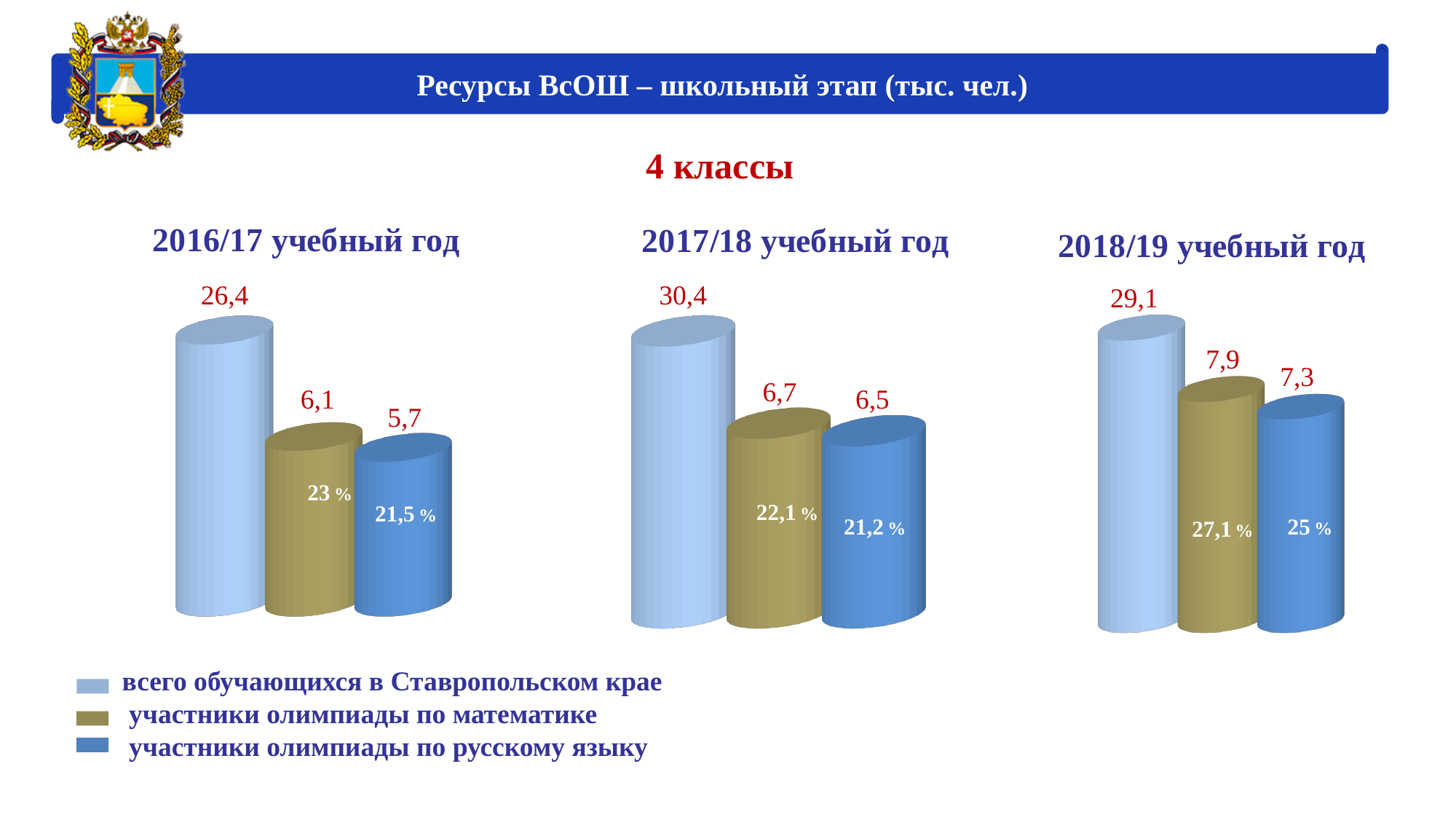
How many bars are shown in the 2016/17 учебный год chart? 3 In the 2016/17 учебный год chart, what is the value for всего обучающихся в Ставропольском крае? 26,4 In the 2017/18 учебный год chart, what is the difference between всего обучающихся в Ставропольском крае and участники олимпиады по математике? 23,7 In the 2017/18 учебный год chart, what is the value for участники олимпиады по математике? 6,7 How many series does the legend list? 3 In the 2018/19 учебный год chart, what percentage is printed on the bar for участники олимпиады по математике? 27,1 % In the 2017/18 учебный год chart, which category has the highest value? всего обучающихся в Ставропольском крае What kind of chart is used for the 2017/18 учебный год data? bar chart Which is larger: участники олимпиады по математике in the 2016/17 учебный год chart or in the 2018/19 учебный год chart? 2018/19 учебный год In the 2018/19 учебный год chart, what is the value for участники олимпиады по русскому языку? 7,3 In the 2016/17 учебный год chart, which category has the lowest value? участники олимпиады по русскому языку In the 2018/19 учебный год chart, what is the difference between участники олимпиады по математике and участники олимпиады по русскому языку? 0,6